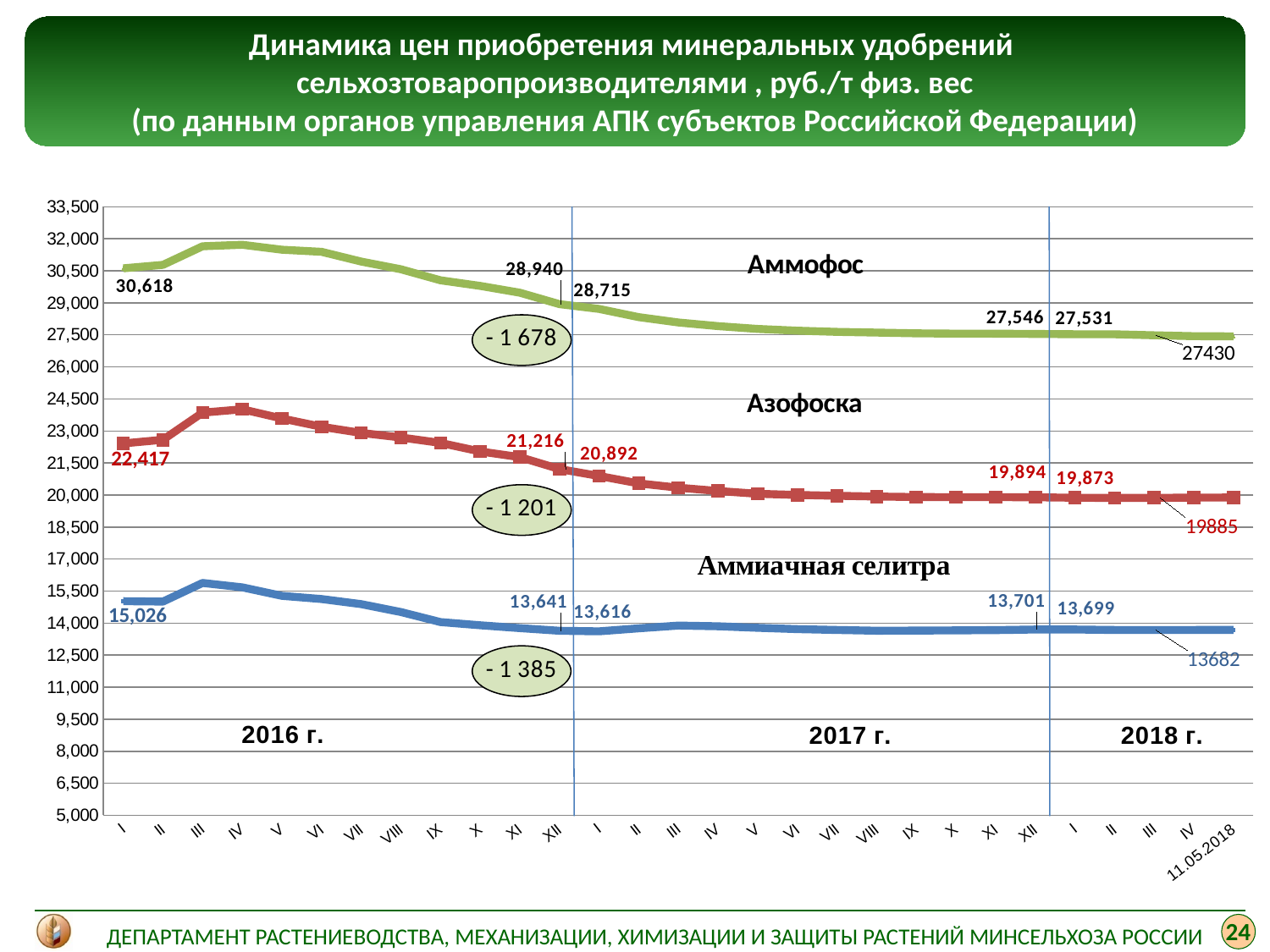
What is the value for Аммофос at the first point (I 2016)? 30,618 Which series has the highest values throughout the chart? Аммофос Is the value for Азофоска at IV 2016 greater or less than 23,000? greater What is the value for Аммиачная селитра at I 2017? 13,616 Which is larger: the Аммиачная селитра value at XII 2017 (13,701) or at 11.05.2018 (13682)? 13,701 (XII 2017) Do the Аммофос values generally rise or fall from I 2016 to 11.05.2018? fall What is the difference between the Аммофос value at I 2016 (30,618) and at XII 2016 (28,940)? 1,678 What is the value for Азофоска at XII 2016? 21,216 Which series has the lowest values throughout the chart? Аммиачная селитра What is the value for Азофоска at I 2018? 19,873 What type of chart is shown on the slide? line chart What is the value for Аммофос at the last point (11.05.2018)? 27430